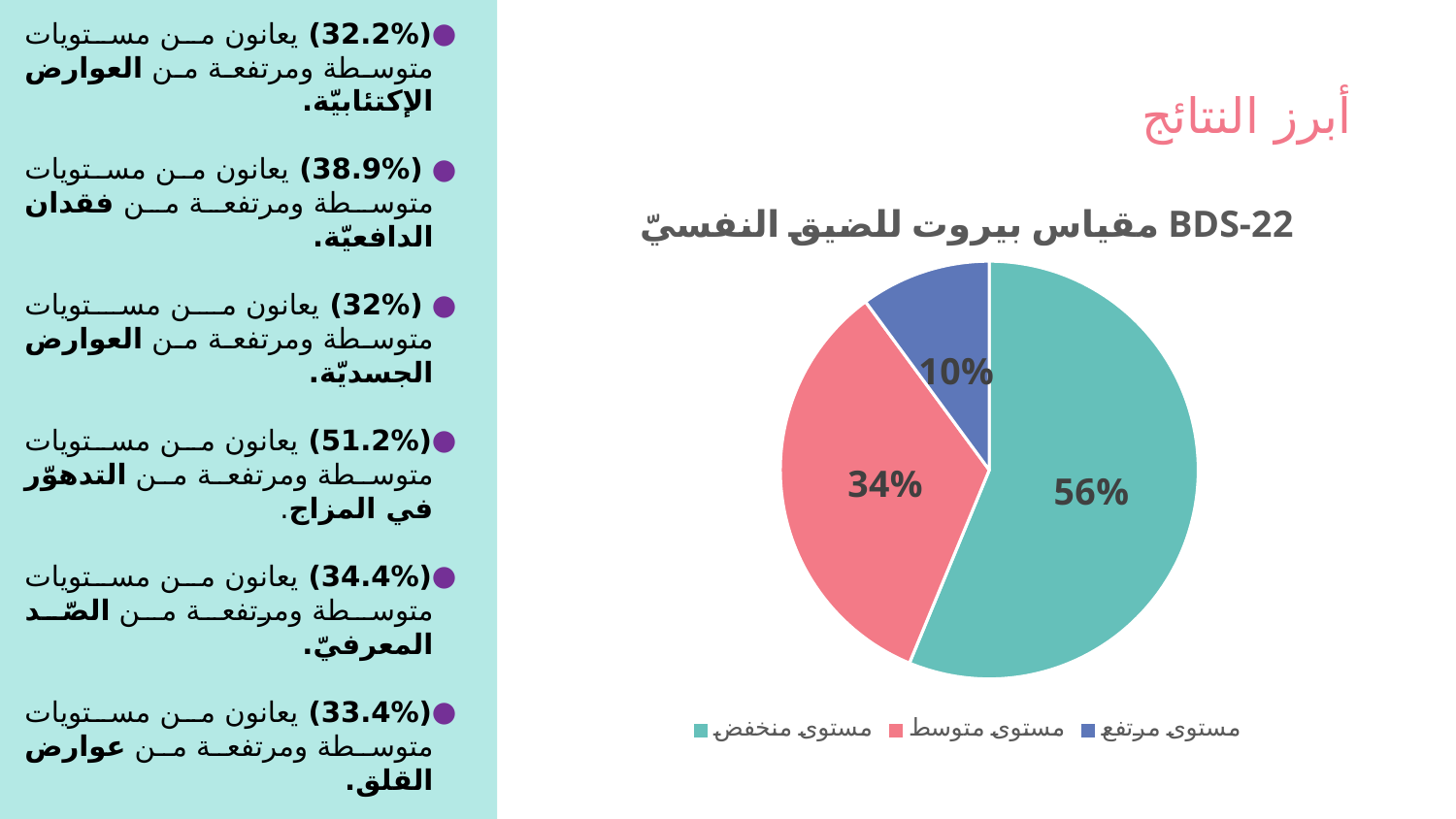
What percentage of the pie is labelled for مستوى متوسط? 34% Which colour represents مستوى مرتفع in the pie chart? blue What kind of chart is shown on the slide? pie chart Which category has the smallest slice of the pie? مستوى مرتفع What is the difference between the مستوى متوسط slice and the مستوى مرتفع slice? 24% What is the difference between the مستوى منخفض slice and the مستوى متوسط slice? 22% What is the title of the pie chart? BDS-22 مقياس بيروت للضيق النفسيّ What percentage of the pie is labelled for مستوى مرتفع? 10% How many slices does the pie chart have? 3 Which is larger, the slice for مستوى متوسط or the slice for مستوى مرتفع? مستوى متوسط Which category has the largest slice of the pie? مستوى منخفض What percentage of the pie is labelled for مستوى منخفض? 56%